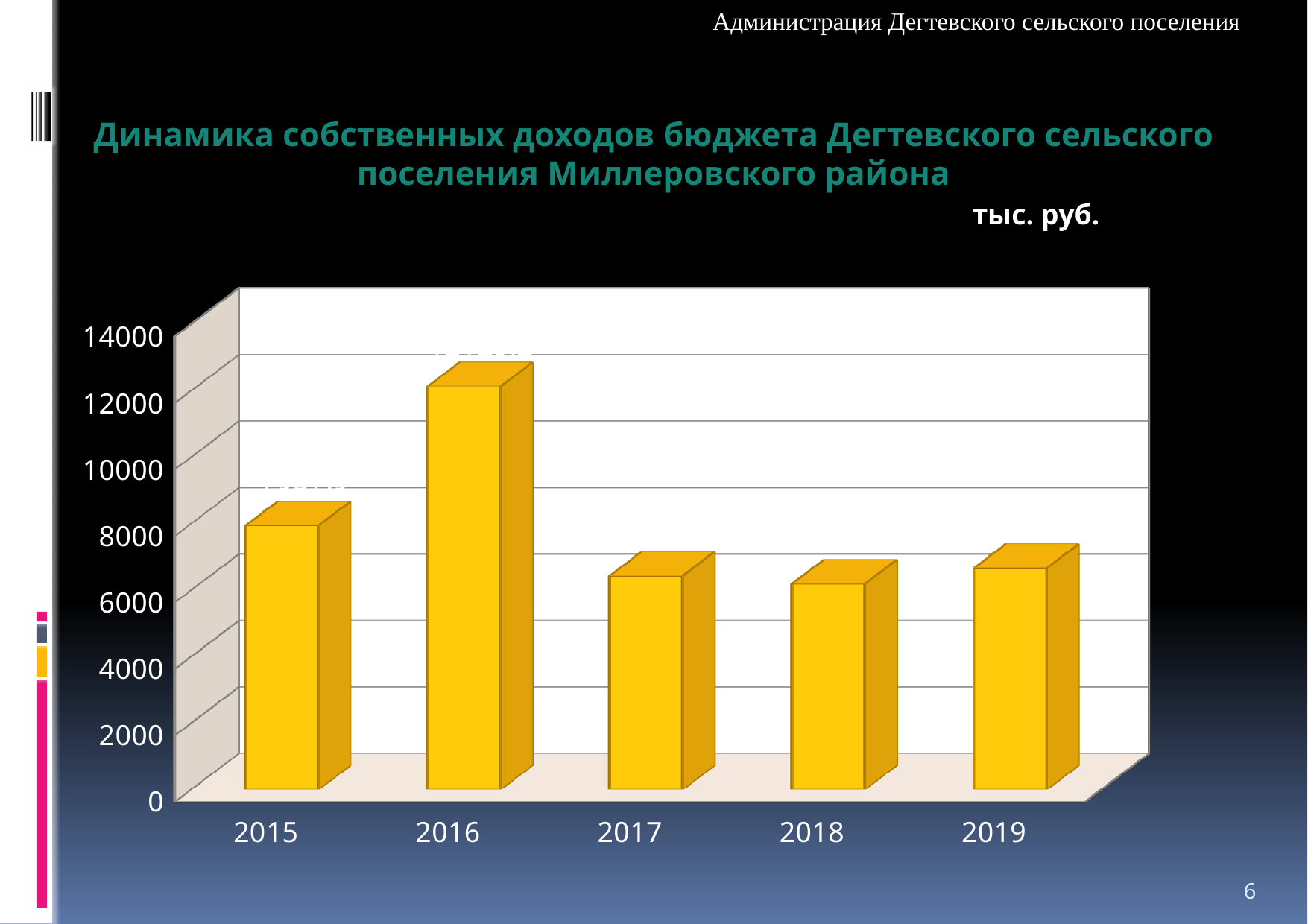
Is the value for 2015 greater or less than 6000? greater What kind of chart is shown on the slide? bar chart In what unit are the values of the chart expressed, according to the slide? тыс. руб. Is the value for 2017 greater or less than 8000? less How many years are shown on the x axis of the chart? 5 Which year has the lowest value in the chart? 2018 What colour are the bars in the chart? yellow Which year has the highest value in the chart? 2016 Is the value for 2019 greater or less than 8000? less Does the value rise or fall from 2016 to 2017? fall Which is larger, the value for 2015 or the value for 2017? 2015